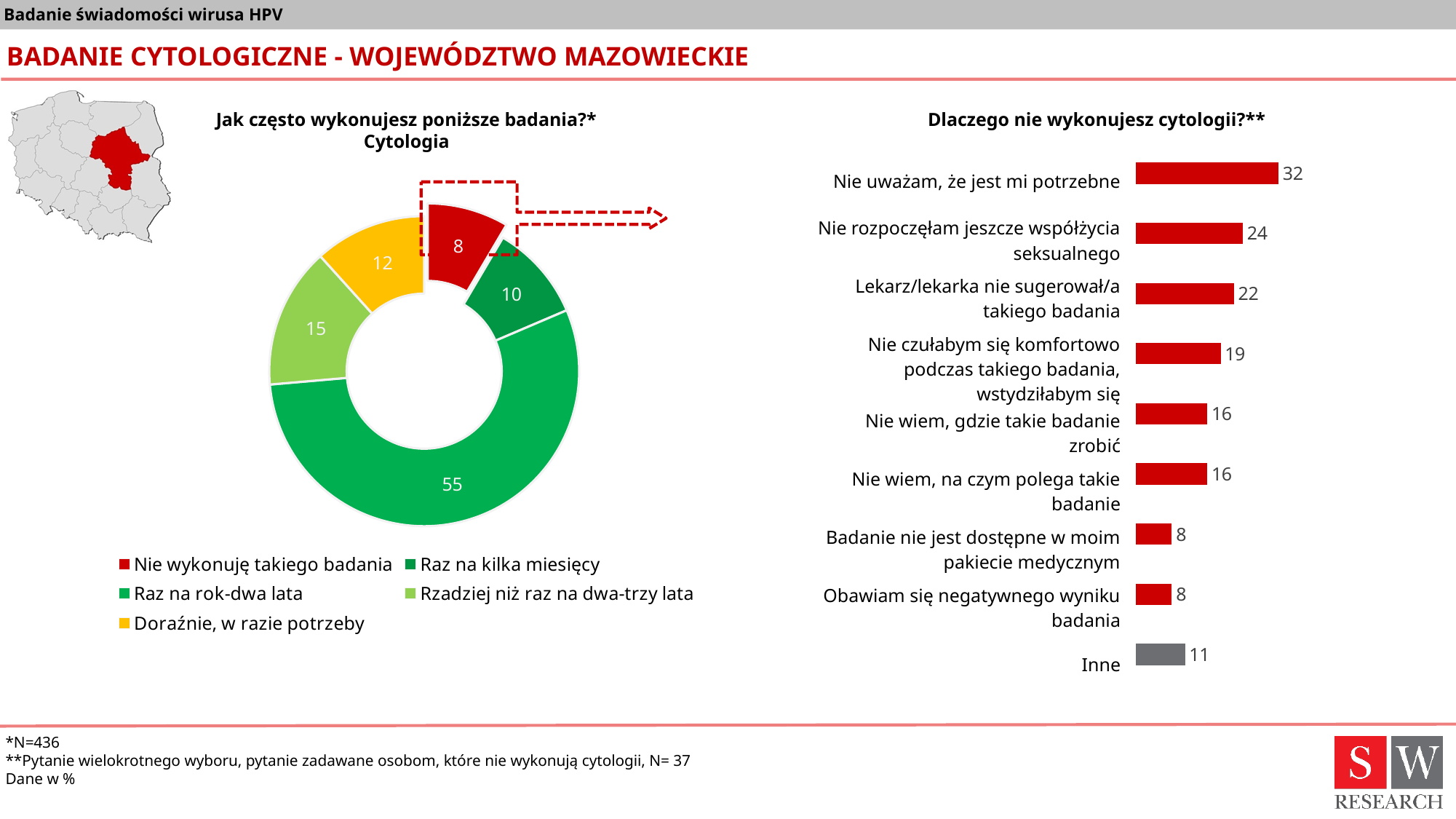
In the donut chart 'Jak często wykonujesz poniższe badania? Cytologia', what is the difference between 'Rzadziej niż raz na dwa-trzy lata' and 'Doraźnie, w razie potrzeby'? 3 In the bar chart 'Dlaczego nie wykonujesz cytologii?', what is the difference between 'Nie rozpoczęłam jeszcze współżycia seksualnego' and 'Lekarz/lekarka nie sugerował/a takiego badania'? 2 In the bar chart 'Dlaczego nie wykonujesz cytologii?', what is the value for 'Nie uważam, że jest mi potrzebne'? 32 In the bar chart 'Dlaczego nie wykonujesz cytologii?', what is the value for 'Inne'? 11 What type of chart is 'Dlaczego nie wykonujesz cytologii?'? Bar chart In the donut chart 'Jak często wykonujesz poniższe badania? Cytologia', which category has the largest share? Raz na rok-dwa lata In the donut chart 'Jak często wykonujesz poniższe badania? Cytologia', how many categories does the legend list? 5 In the bar chart 'Dlaczego nie wykonujesz cytologii?', which is larger: 'Nie czułabym się komfortowo podczas takiego badania, wstydziłabym się' or 'Nie wiem, gdzie takie badanie zrobić'? Nie czułabym się komfortowo podczas takiego badania, wstydziłabym się In the bar chart 'Dlaczego nie wykonujesz cytologii?', which reason has the highest value? Nie uważam, że jest mi potrzebne In the donut chart 'Jak często wykonujesz poniższe badania? Cytologia', what is the value for 'Raz na rok-dwa lata'? 55 In the donut chart 'Jak często wykonujesz poniższe badania? Cytologia', which category has the smallest share? Nie wykonuję takiego badania In the donut chart 'Jak często wykonujesz poniższe badania? Cytologia', what is the value for 'Nie wykonuję takiego badania'? 8